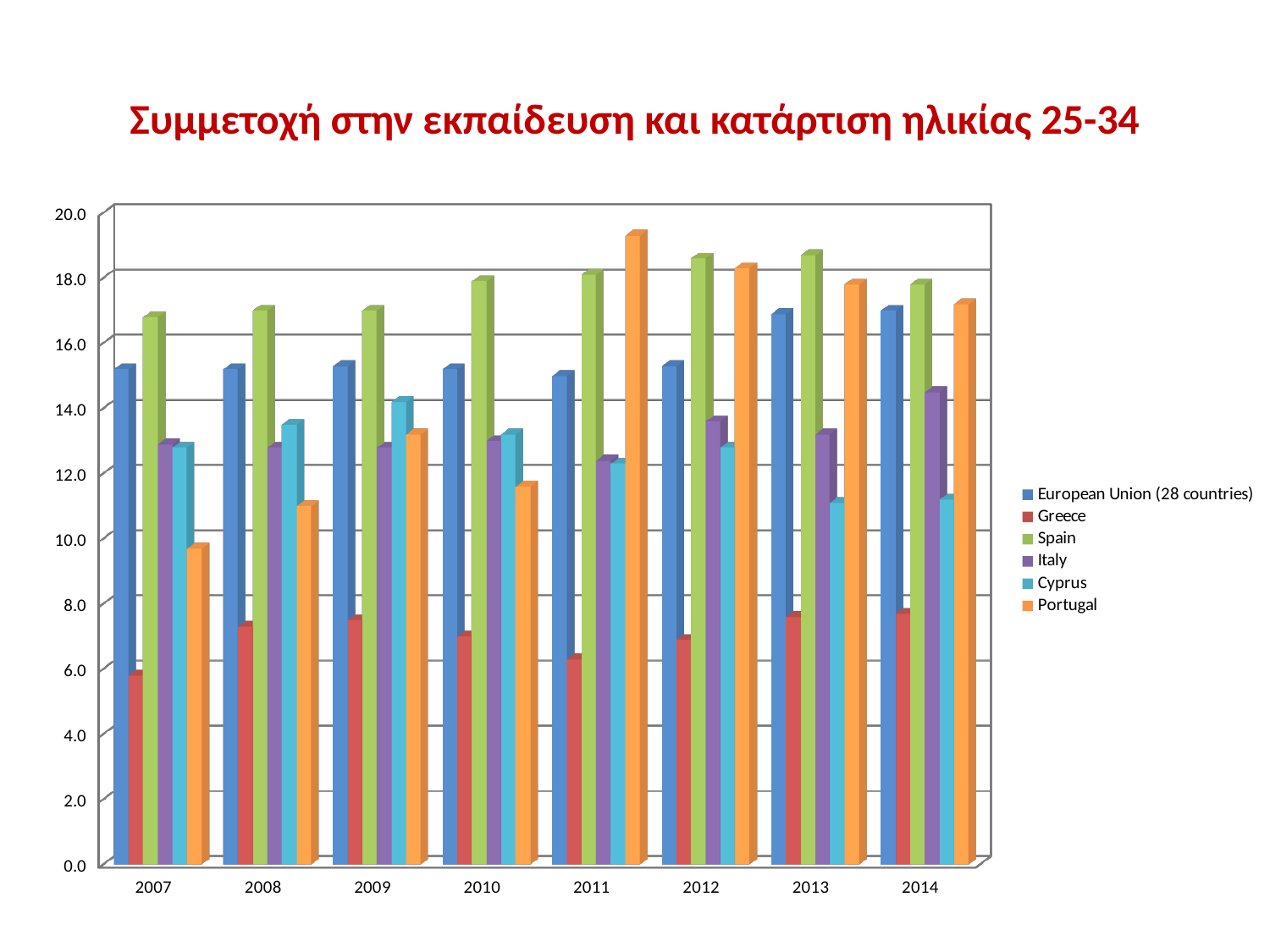
Which is larger in 2013, the value for Portugal or the value for Cyprus? Portugal How many years are shown on the x axis? 8 Is the value for Portugal in 2011 greater or less than 18.0? greater Is the value for Greece in 2007 greater or less than 8.0? less Which is larger in 2014, the value for Spain or the value for Greece? Spain Do the values for Portugal rise or fall from 2007 to 2011? rise Which country has the lowest value in 2007? Greece Which series has the highest value in 2011? Portugal Is the value for Spain in 2013 greater or less than 18.0? greater What kind of chart is shown on the slide? bar chart How many series does the legend list? 6 Which colour represents Spain in the legend? green